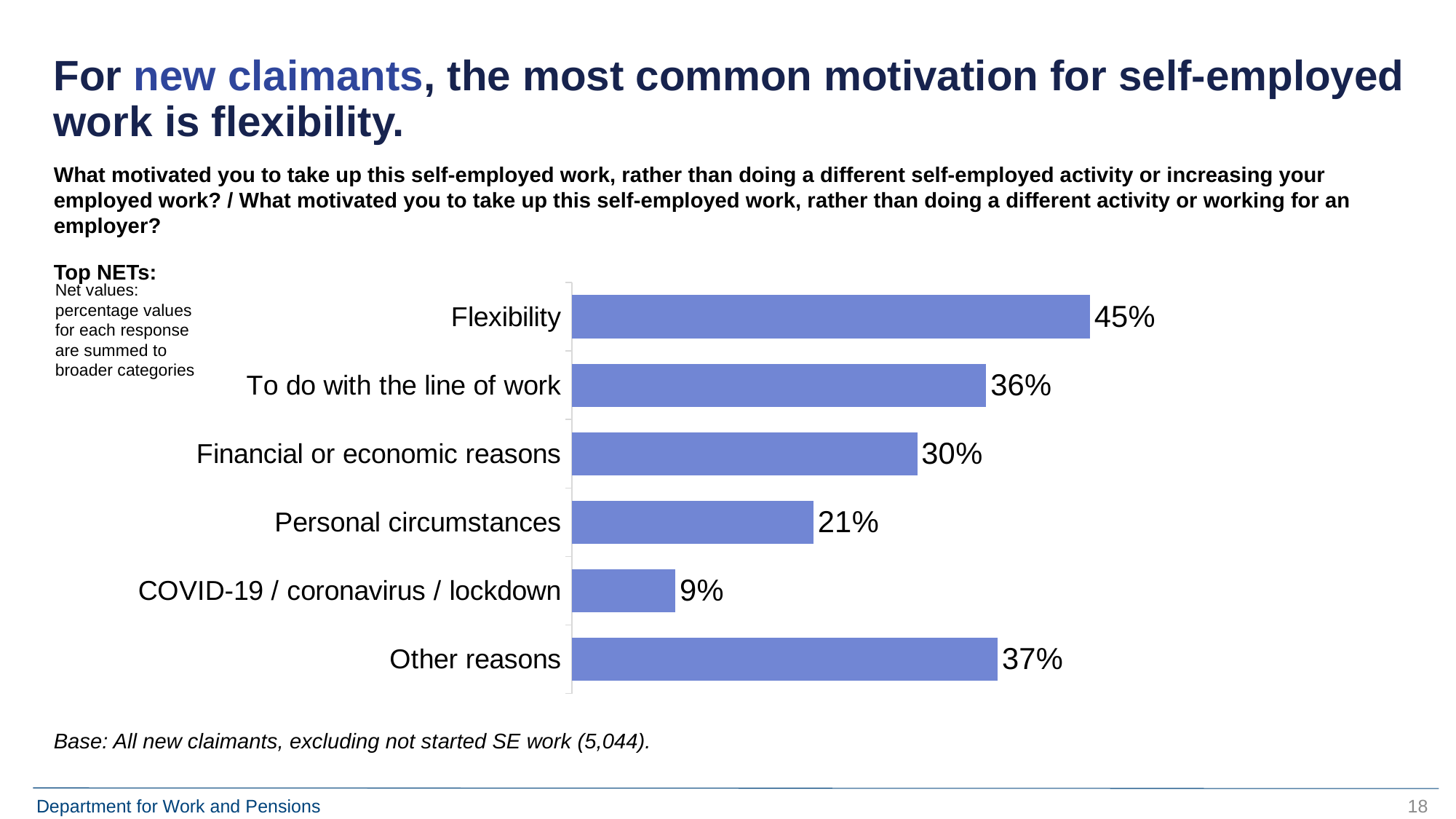
How many categories are shown in the chart? 6 What type of chart is shown on the slide? Bar chart Which is larger: the value for 'Other reasons' or the value for 'To do with the line of work'? Other reasons Which category has the lowest value in the chart? COVID-19 / coronavirus / lockdown What is the difference between the values for 'Financial or economic reasons' and 'COVID-19 / coronavirus / lockdown'? 21 percentage points What is the value for 'COVID-19 / coronavirus / lockdown'? 9% What is the value shown for 'To do with the line of work'? 36% Which category has the highest value in the chart? Flexibility What percentage is shown for 'Financial or economic reasons'? 30% What percentage of new claimants cited Flexibility as a motivation for self-employed work? 45% What is the difference between the values for Flexibility and Personal circumstances? 24 percentage points What is the base size stated below the chart? 5,044